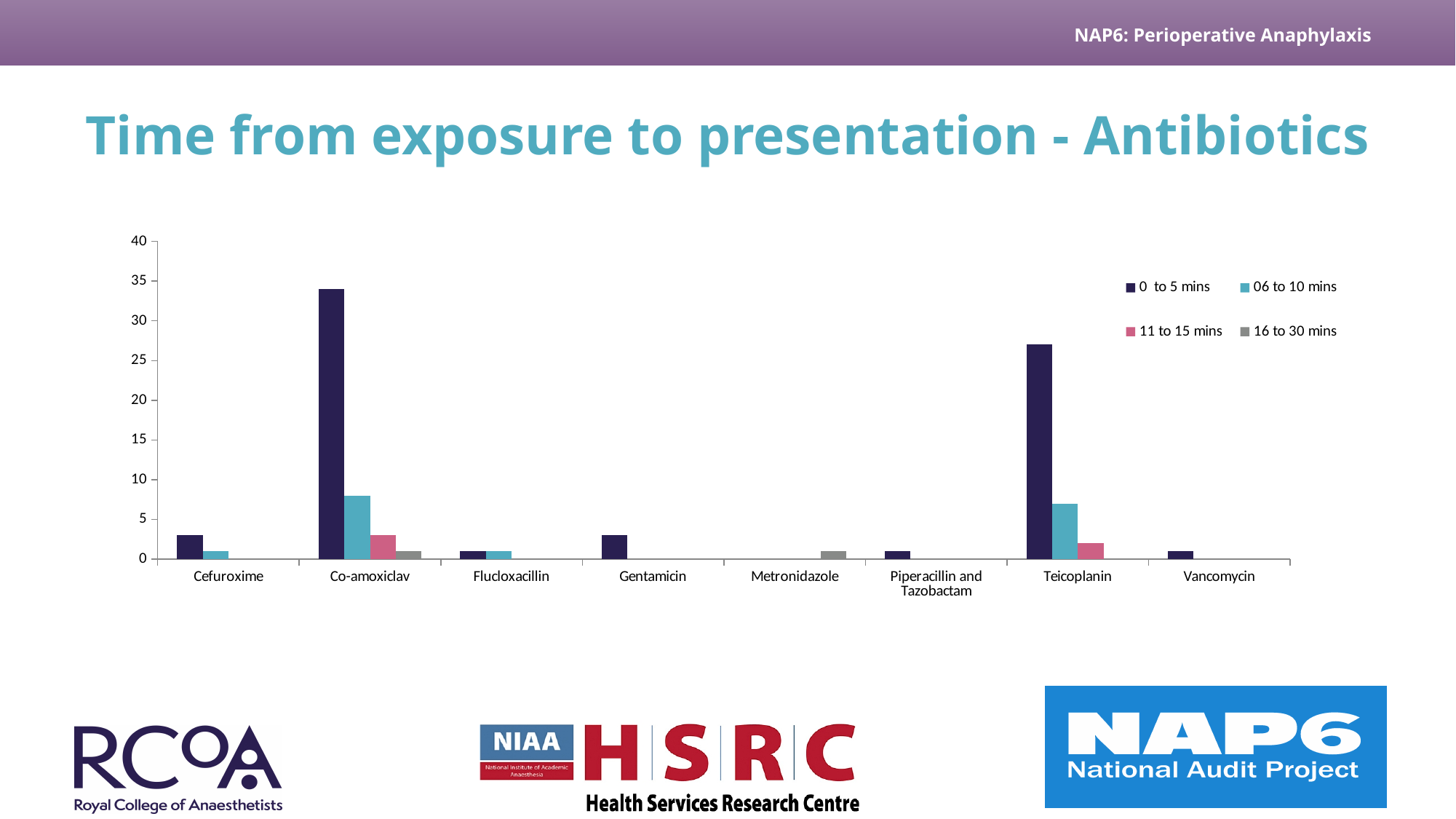
Is the 0 to 5 mins value for Teicoplanin greater or less than 25? greater Is the 0 to 5 mins value for Cefuroxime greater or less than 5? less What kind of chart is shown on the slide? bar chart How many series does the legend list? 4 Which antibiotic has the highest value for the 0 to 5 mins series? Co-amoxiclav How many antibiotic categories are shown on the x axis? 8 Which is larger for the 0 to 5 mins series: Co-amoxiclav or Teicoplanin? Co-amoxiclav How many antibiotic categories show a bar for the 16 to 30 mins series? 2 Is the 0 to 5 mins value for Co-amoxiclav greater or less than 30? greater What is the title of the chart? Time from exposure to presentation - Antibiotics